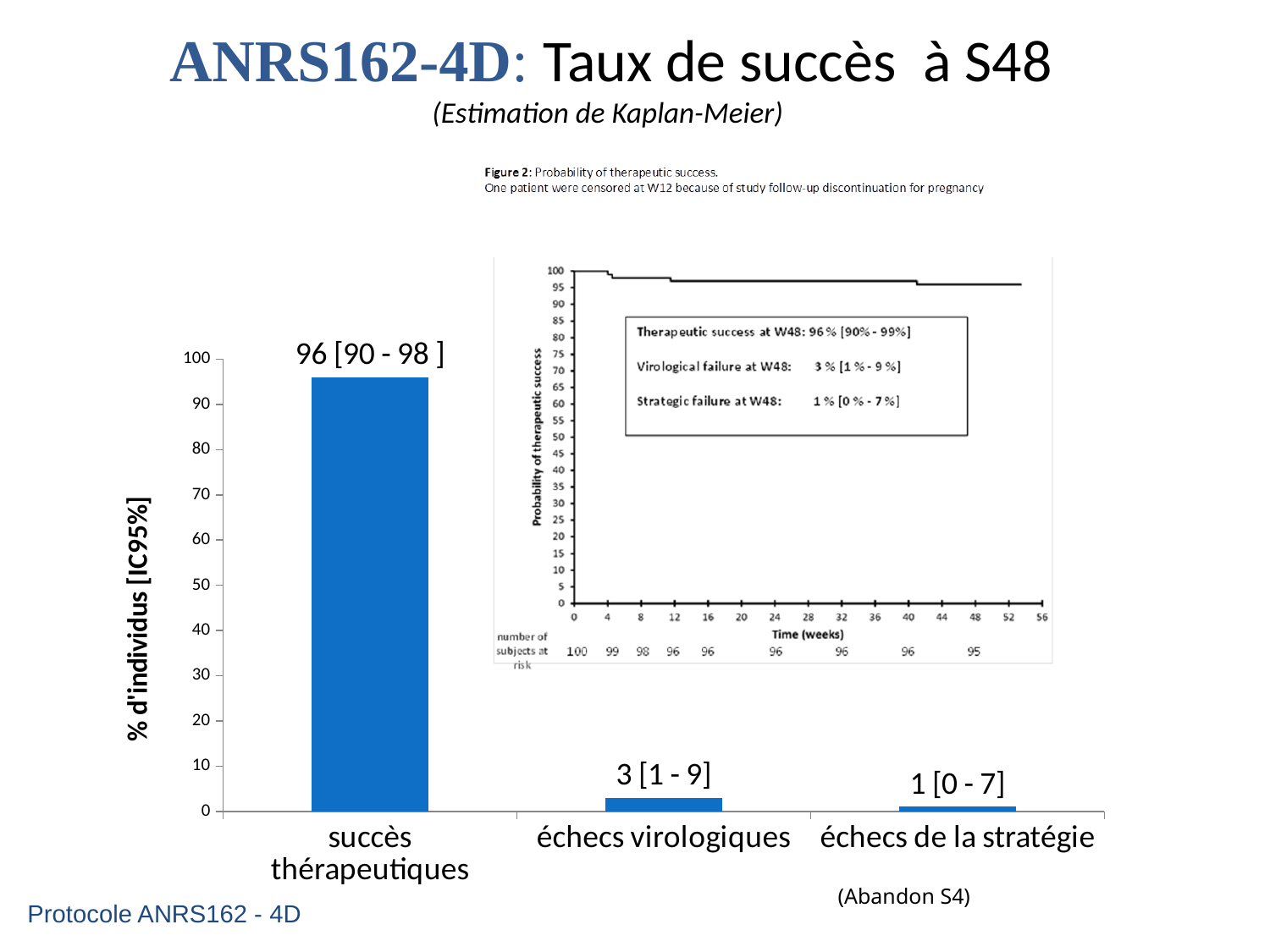
In the bar chart, which is larger: échecs virologiques or échecs de la stratégie? échecs virologiques How many categories does the bar chart show? 3 In the bar chart, what is the difference between the point estimates for succès thérapeutiques and échecs virologiques? 93 What is the y-axis label of the bar chart? % d'individus [IC95%] In the bar chart, what is the data label for échecs de la stratégie? 1 [0 - 7] In the bar chart, which category has the highest value? succès thérapeutiques In the Kaplan-Meier figure (Figure 2), what is the therapeutic success at W48 shown in the text box? 96 % [90% - 99%] What kind of chart is the chart on the left of the slide? bar chart In the bar chart, what is the data label for échecs virologiques? 3 [1 - 9] In the bar chart, is the value for succès thérapeutiques greater or less than 90? greater In the bar chart, what is the data label for succès thérapeutiques? 96 [90 - 98 ] In the bar chart, which category has the lowest value? échecs de la stratégie